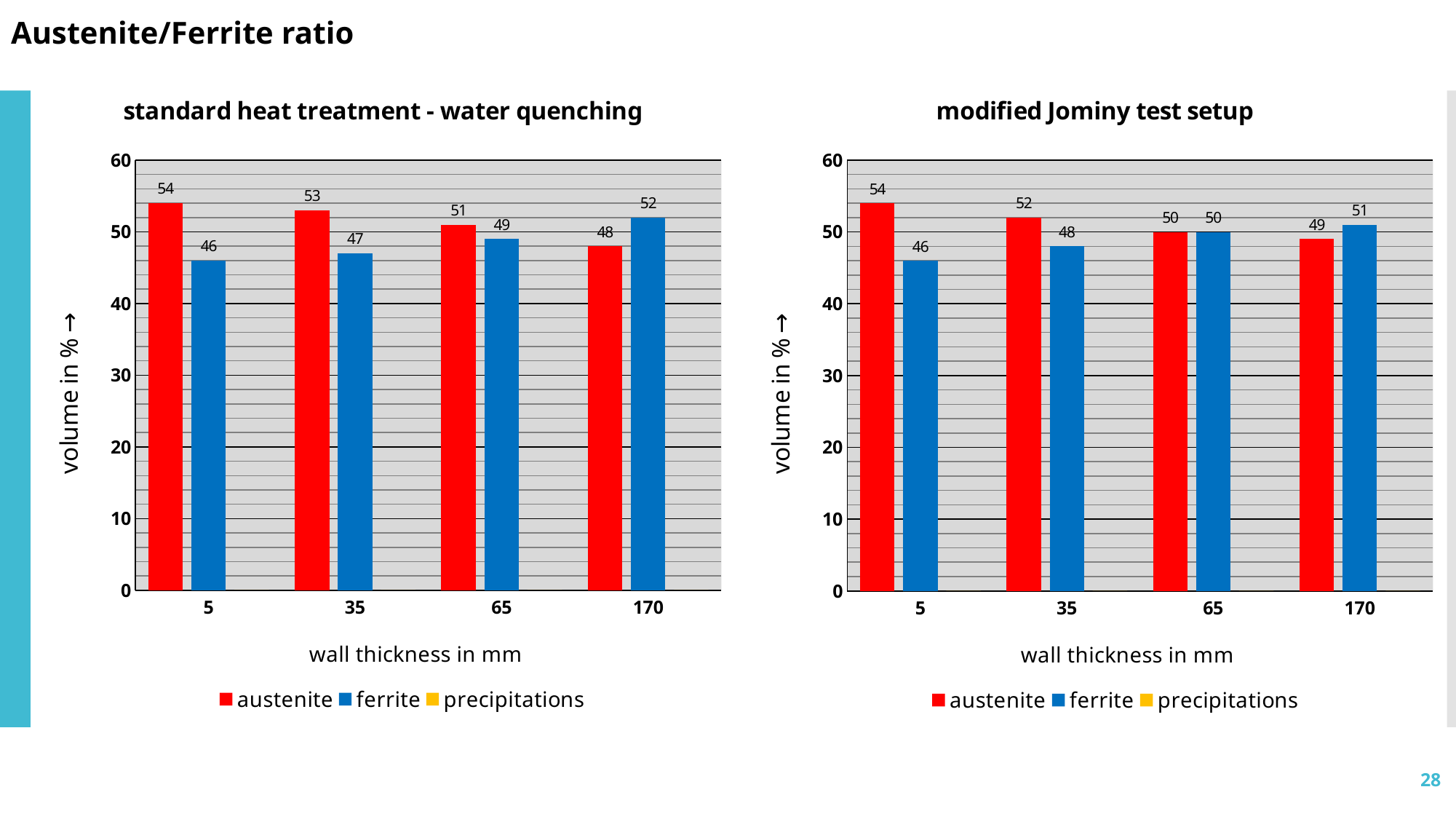
In the 'modified Jominy test setup' chart, what is the ferrite value at a wall thickness of 35 mm? 48 How many wall thickness categories are shown in the 'modified Jominy test setup' chart? 4 How many series does the legend of the 'standard heat treatment - water quenching' chart list? 3 In the 'modified Jominy test setup' chart, what is the austenite value at a wall thickness of 170 mm? 49 In the 'standard heat treatment - water quenching' chart, what is the austenite value at a wall thickness of 5 mm? 54 In the 'standard heat treatment - water quenching' chart, at which wall thickness is the austenite value lowest? 170 In the 'standard heat treatment - water quenching' chart, what is the ferrite value at a wall thickness of 170 mm? 52 In the 'standard heat treatment - water quenching' chart, which is larger at a wall thickness of 65 mm: austenite or ferrite? austenite In the 'modified Jominy test setup' chart, at which wall thickness is the ferrite value highest? 170 In the 'modified Jominy test setup' chart, what is the difference between the ferrite values at 170 mm and 5 mm wall thickness? 5 What type of chart is the 'modified Jominy test setup' chart? bar chart In the 'standard heat treatment - water quenching' chart, what is the difference between the austenite and ferrite values at a wall thickness of 5 mm? 8